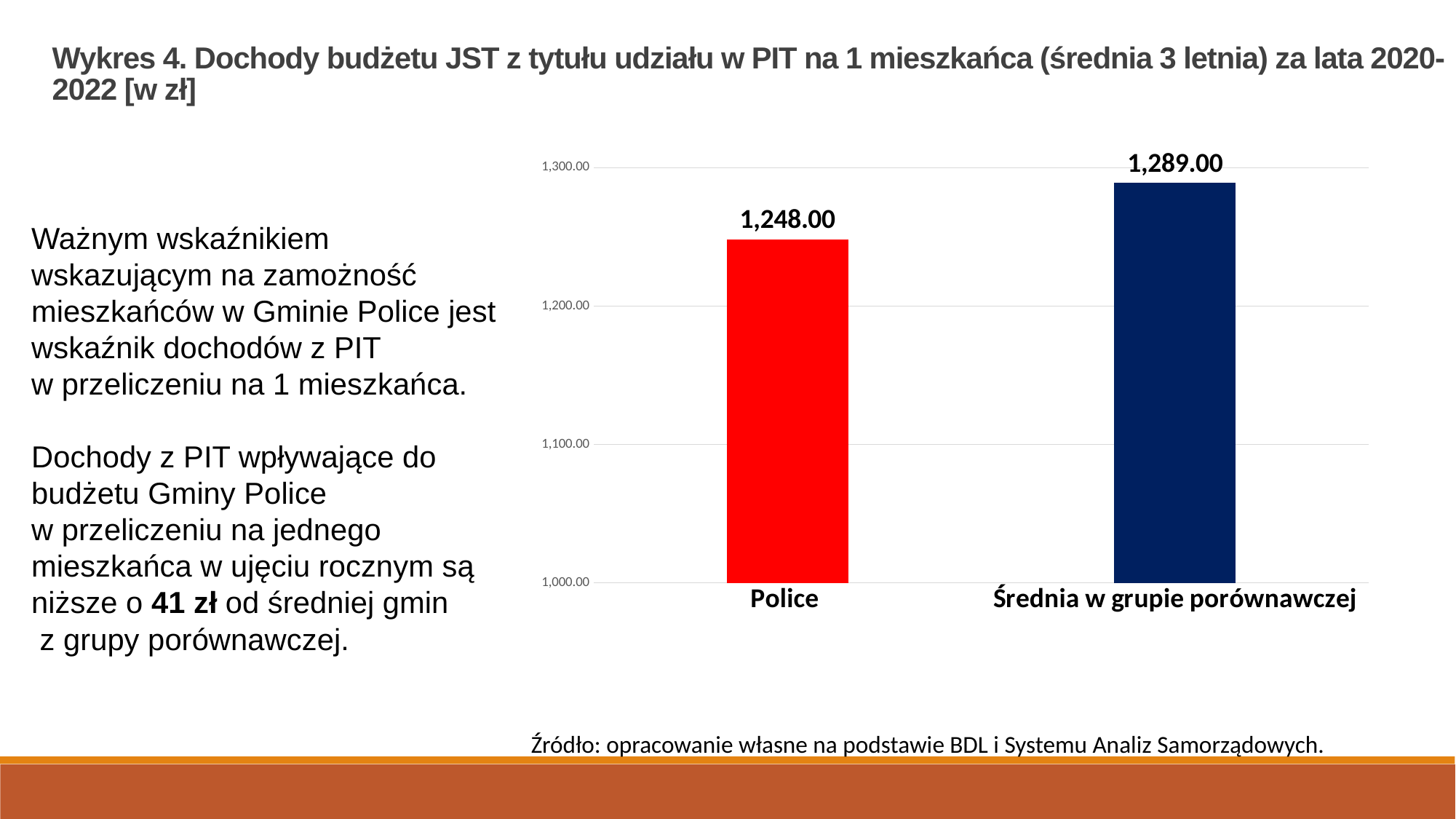
Which is larger, the value for Police or the value for Średnia w grupie porównawczej? Średnia w grupie porównawczej What is the value for Police? 1,248.00 Which category has the lowest value? Police How many categories are shown in the chart? 2 Is the value for Police greater or less than 1,200.00? greater What is the difference between the value for Średnia w grupie porównawczej and the value for Police? 41.00 Which category has the highest value? Średnia w grupie porównawczej What colour is the bar for Police? red What kind of chart is shown on the slide? bar chart What is the value for Średnia w grupie porównawczej? 1,289.00 Is the value for Średnia w grupie porównawczej greater or less than 1,300.00? less What is the highest value shown on the vertical axis? 1,300.00